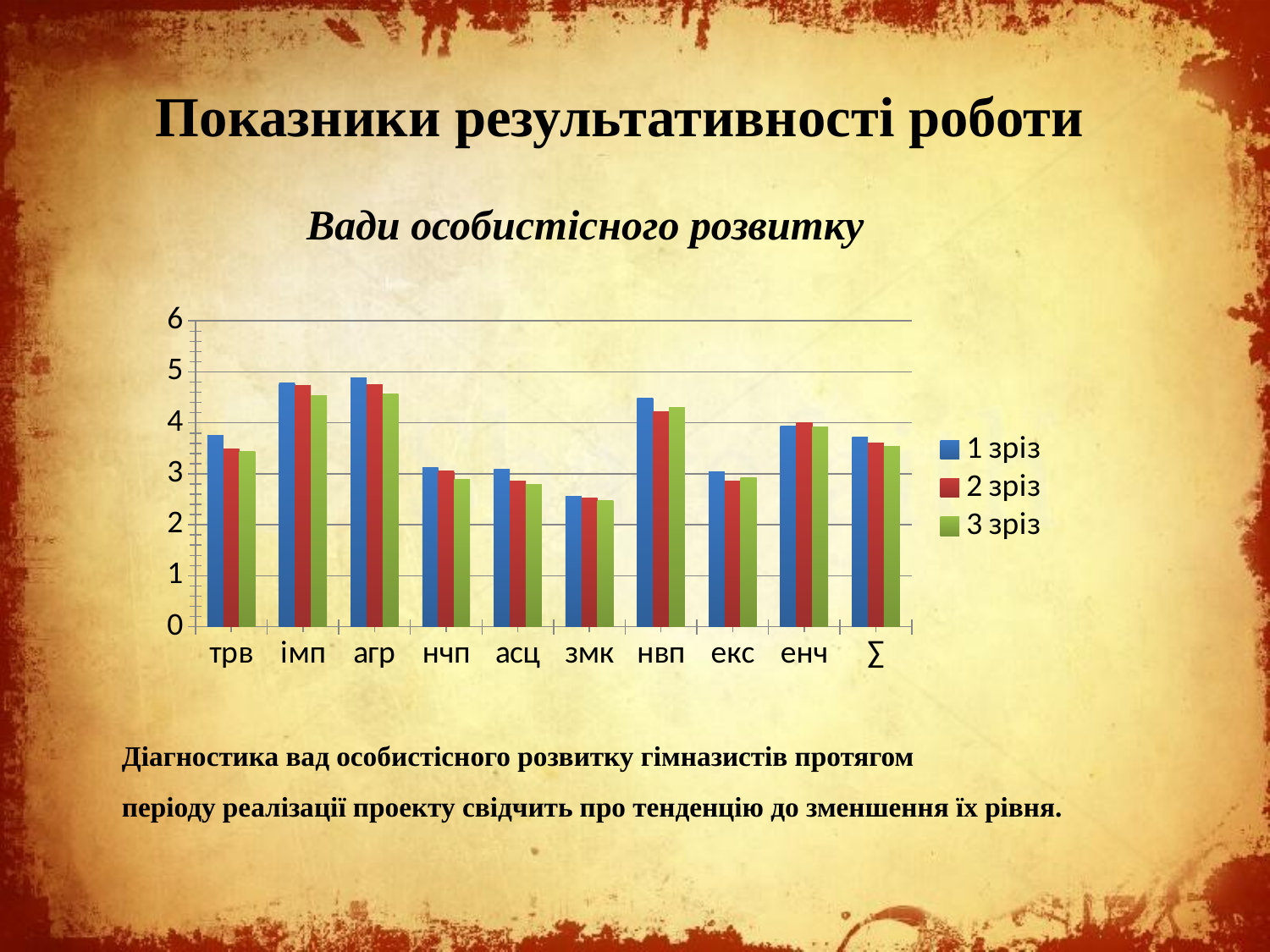
Which is larger: the 1 зріз value for трв or the 1 зріз value for нчп? трв What is the name of the first series in the legend? 1 зріз Is the value for 1 зріз in category агр greater or less than 4? greater How many series does the legend list? 3 Is the value for 1 зріз in category змк greater or less than 3? less Which category has the lowest values across all three series? змк Is the value for 2 зріз in category екс greater or less than 3? less How many categories are shown on the x axis? 10 In category нвп, do the values rise or fall from 1 зріз to 2 зріз? fall What kind of chart is shown on the slide? bar chart